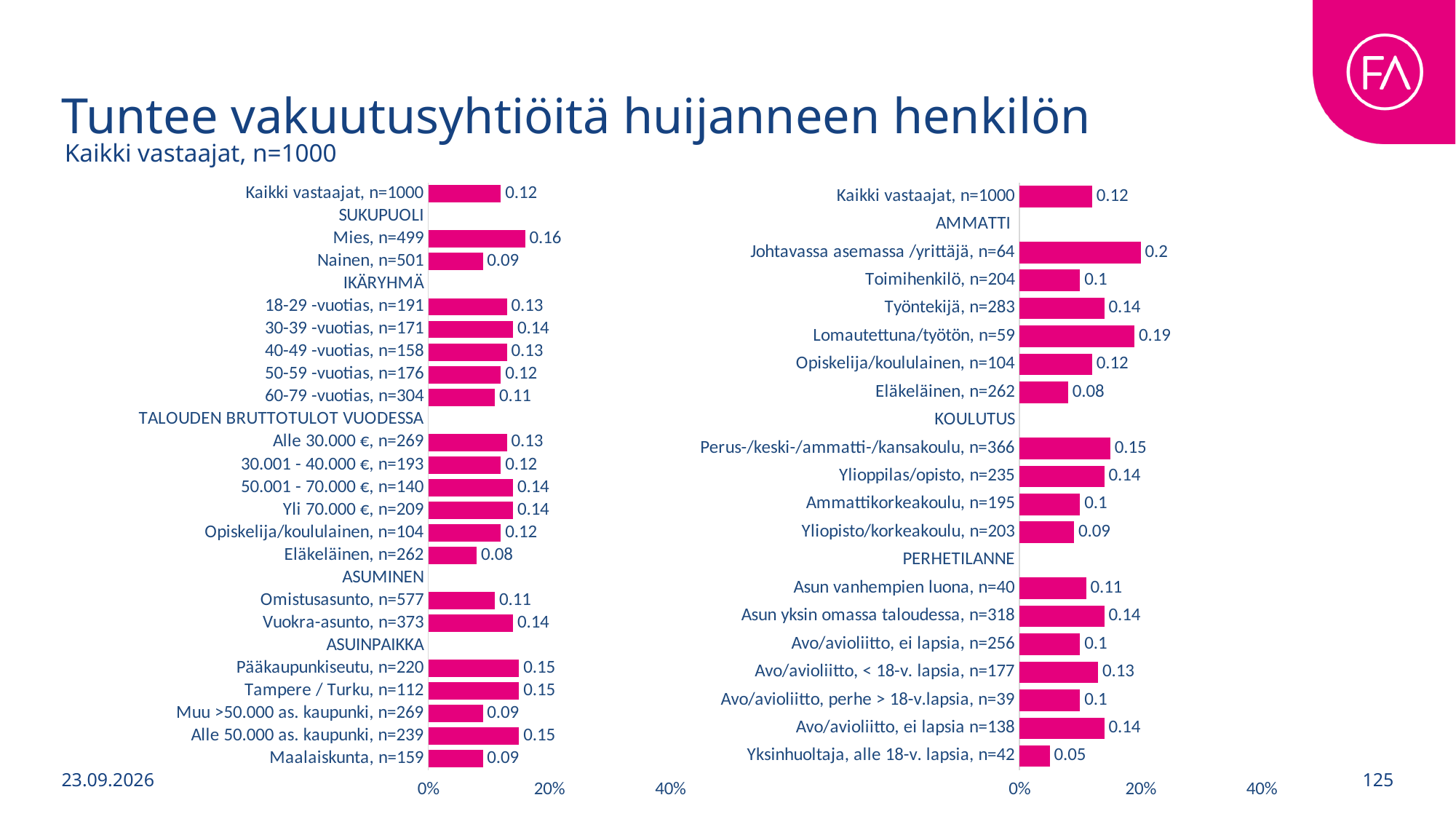
In the right chart, which is larger: the value for Toimihenkilö, n=204 or Työntekijä, n=283? Työntekijä, n=283 In the left chart, what is the value for Mies, n=499? 0.16 In the left chart, is the value for Pääkaupunkiseutu, n=220 greater or less than 20%? less In the left chart, what is the value for Vuokra-asunto, n=373? 0.14 What is the value for Kaikki vastaajat, n=1000 in the right chart? 0.12 In the right chart, which category has the highest value? Johtavassa asemassa /yrittäjä, n=64 In the right chart, what is the value for Yliopisto/korkeakoulu, n=203? 0.09 In the right chart, which category has the lowest value? Yksinhuoltaja, alle 18-v. lapsia, n=42 In the right chart, what is the value for Lomautettuna/työtön, n=59? 0.19 What kind of chart is shown on the left side of the slide? bar chart In the left chart, which category has the highest value? Mies, n=499 In the left chart, what is the difference between the values for Mies, n=499 and Nainen, n=501? 0.07